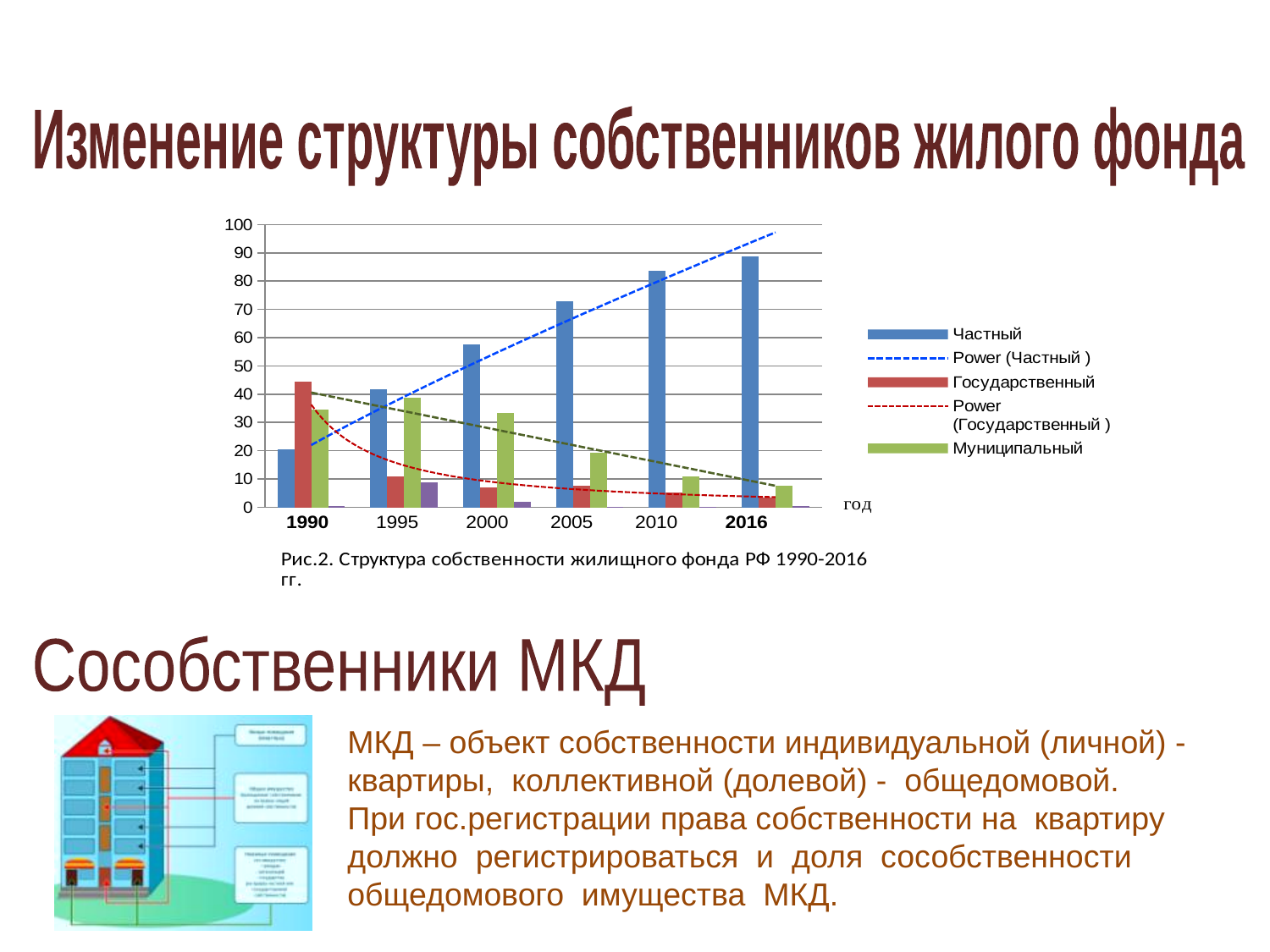
Is the value for Государственный in 1990 greater or less than 40? greater What kind of chart is shown on the slide? bar chart How many entries does the chart's legend list? 5 How many years are shown on the x axis of the chart? 6 In which year is the Частный bar the lowest? 1990 In 1990, which is larger: the Частный bar or the Государственный bar? Государственный Is the value for Частный in 1990 greater or less than 30? less In which year is the Государственный bar the highest? 1990 In which year is the Частный bar the highest? 2016 Is the value for Частный in 2016 greater or less than 80? greater Do the Частный values rise or fall from 1990 to 2016? rise What label is shown at the end of the x axis? год